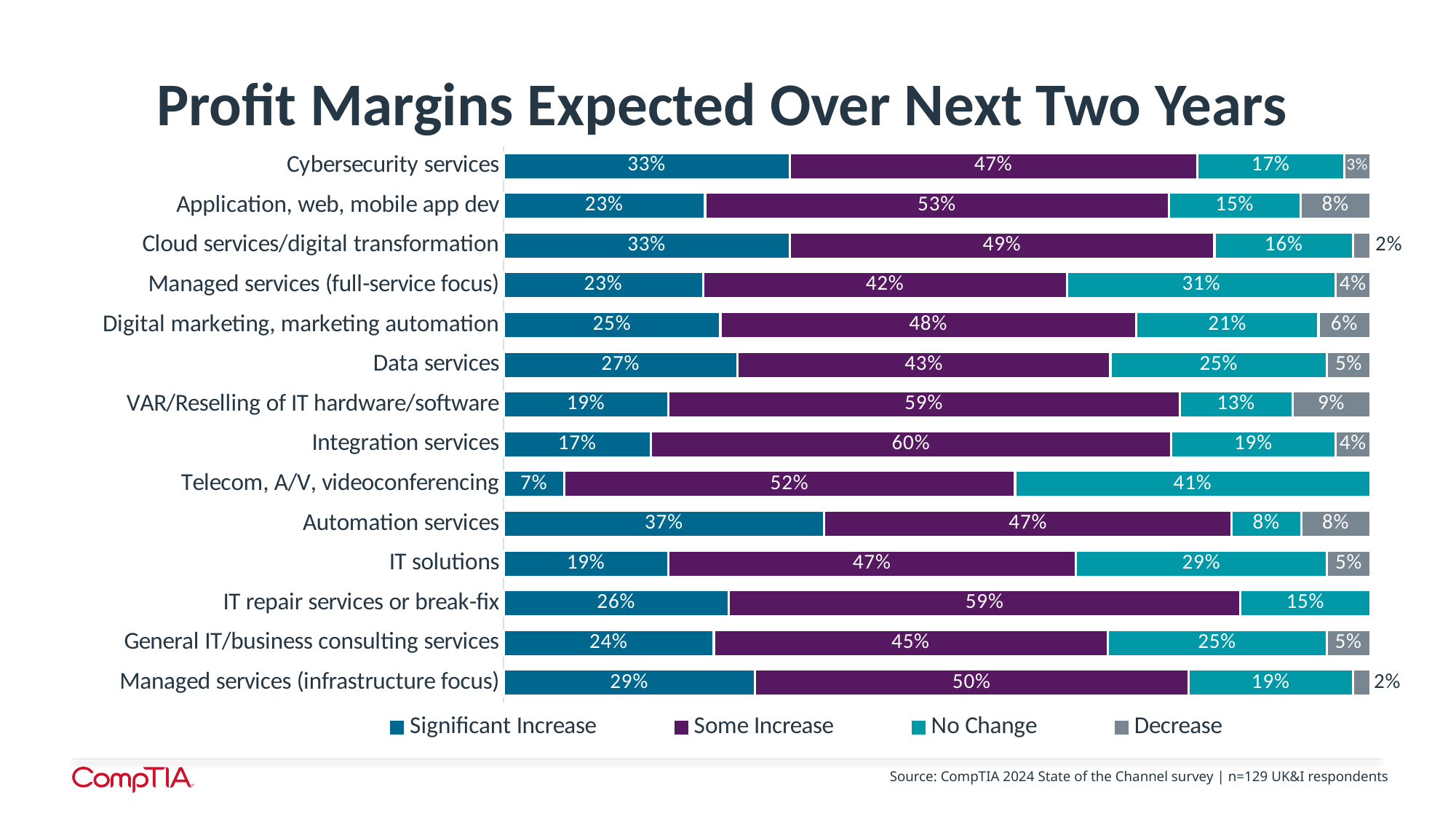
What is the Decrease value for VAR/Reselling of IT hardware/software? 9% How many categories (service types) are plotted on the chart? 14 What kind of chart is shown on the slide? Stacked bar chart What is the Significant Increase value for Automation services? 37% Which has a larger Significant Increase value: Data services or Digital marketing, marketing automation? Data services Which category has the lowest Significant Increase value? Telecom, A/V, videoconferencing What is the Some Increase value for Integration services? 60% Which category has the highest Significant Increase value? Automation services For Cybersecurity services, what is the difference between the Some Increase value and the Significant Increase value? 14 percentage points Which category has the highest No Change value? Telecom, A/V, videoconferencing What is the No Change value for Telecom, A/V, videoconferencing? 41% How many series does the legend list? 4